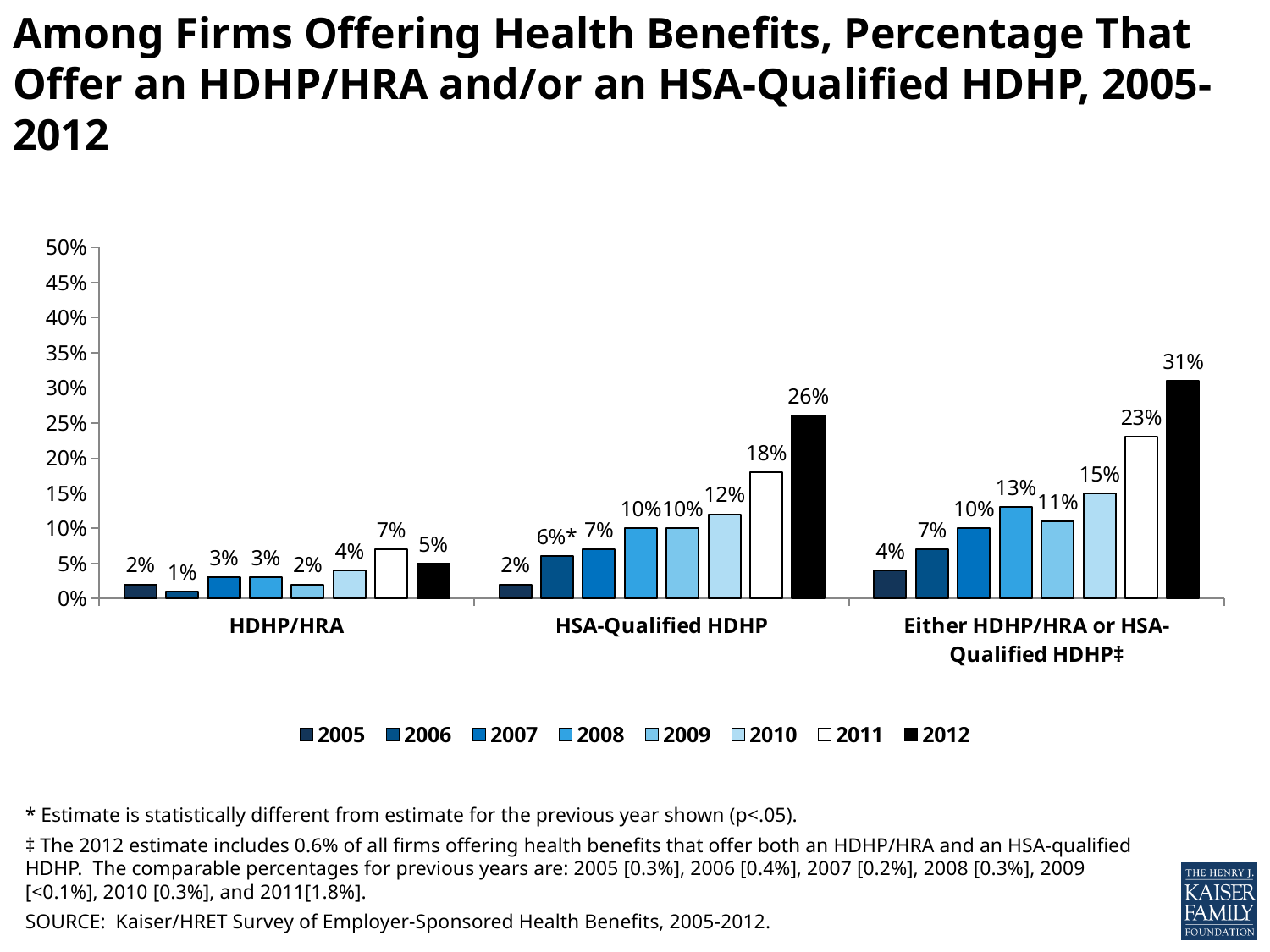
What is the value for 2011 in the HSA-Qualified HDHP category? 18% What colour are the bars for 2012? black What kind of chart is shown on the slide? bar chart How many categories are shown on the x axis? 3 How many series does the legend list? 8 Which is larger: the 2012 value for HDHP/HRA or the 2012 value for HSA-Qualified HDHP? HSA-Qualified HDHP What is the value for 2006 in the HDHP/HRA category? 1% What is the difference between the 2012 and 2011 values in the HSA-Qualified HDHP category? 8% Which year has the highest value in the HDHP/HRA category? 2011 What is the value for 2012 in the Either HDHP/HRA or HSA-Qualified HDHP category? 31% Is the 2012 value for Either HDHP/HRA or HSA-Qualified HDHP greater or less than 30%? greater Which year has the lowest value in the Either HDHP/HRA or HSA-Qualified HDHP category? 2005